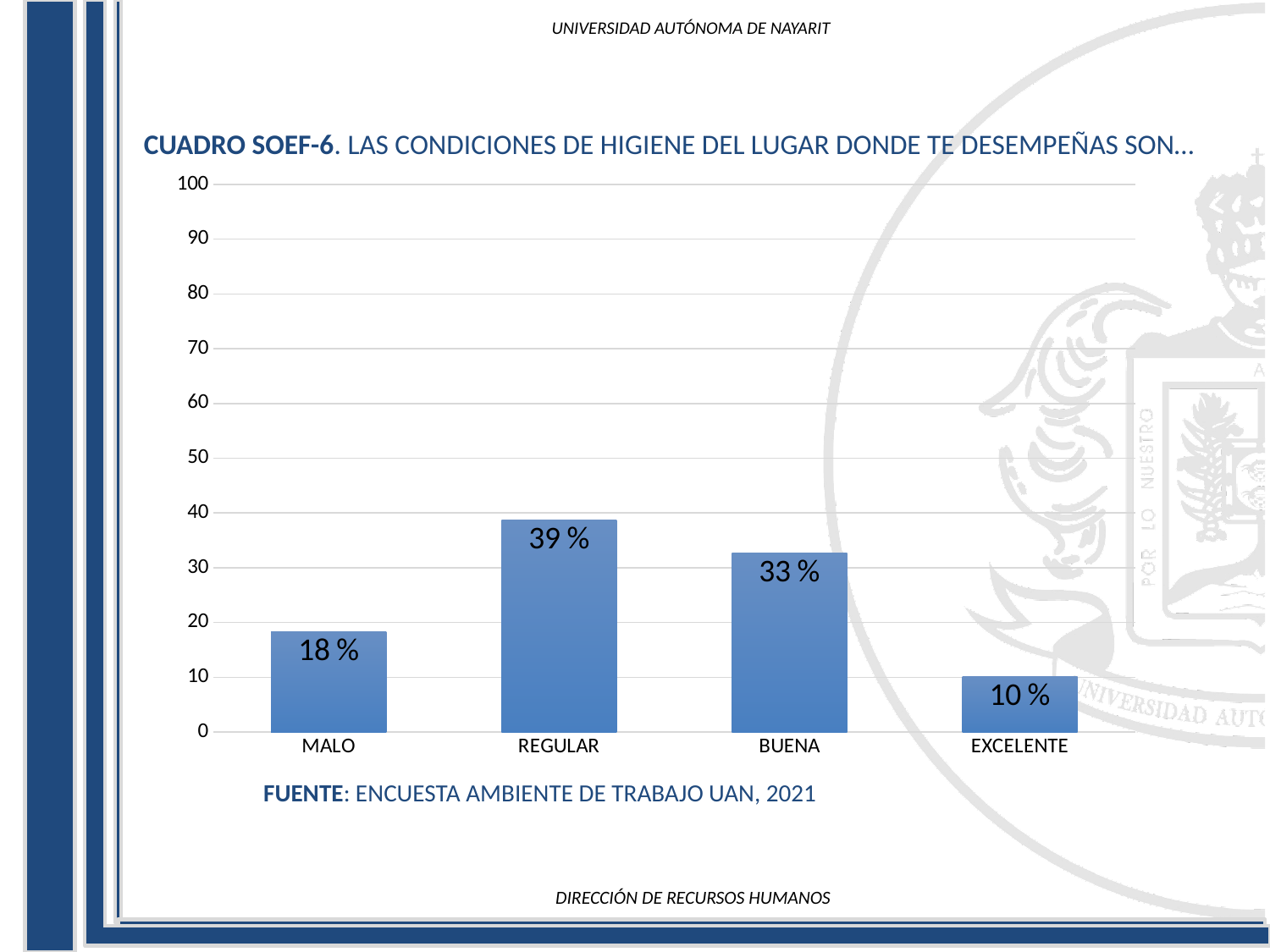
What is the maximum value shown on the y axis? 100 What is the difference between the values for REGULAR and BUENA? 6 % What kind of chart is shown on the slide? bar chart What source is cited below the chart? ENCUESTA AMBIENTE DE TRABAJO UAN, 2021 What is the value for REGULAR? 39 % What is the value for EXCELENTE? 10 % Which category has the highest value? REGULAR What is the value for MALO? 18 % Which category has the lowest value? EXCELENTE Is the value for BUENA greater or less than 40? less Which is larger, the value for MALO or the value for BUENA? BUENA How many categories are shown on the x axis? 4